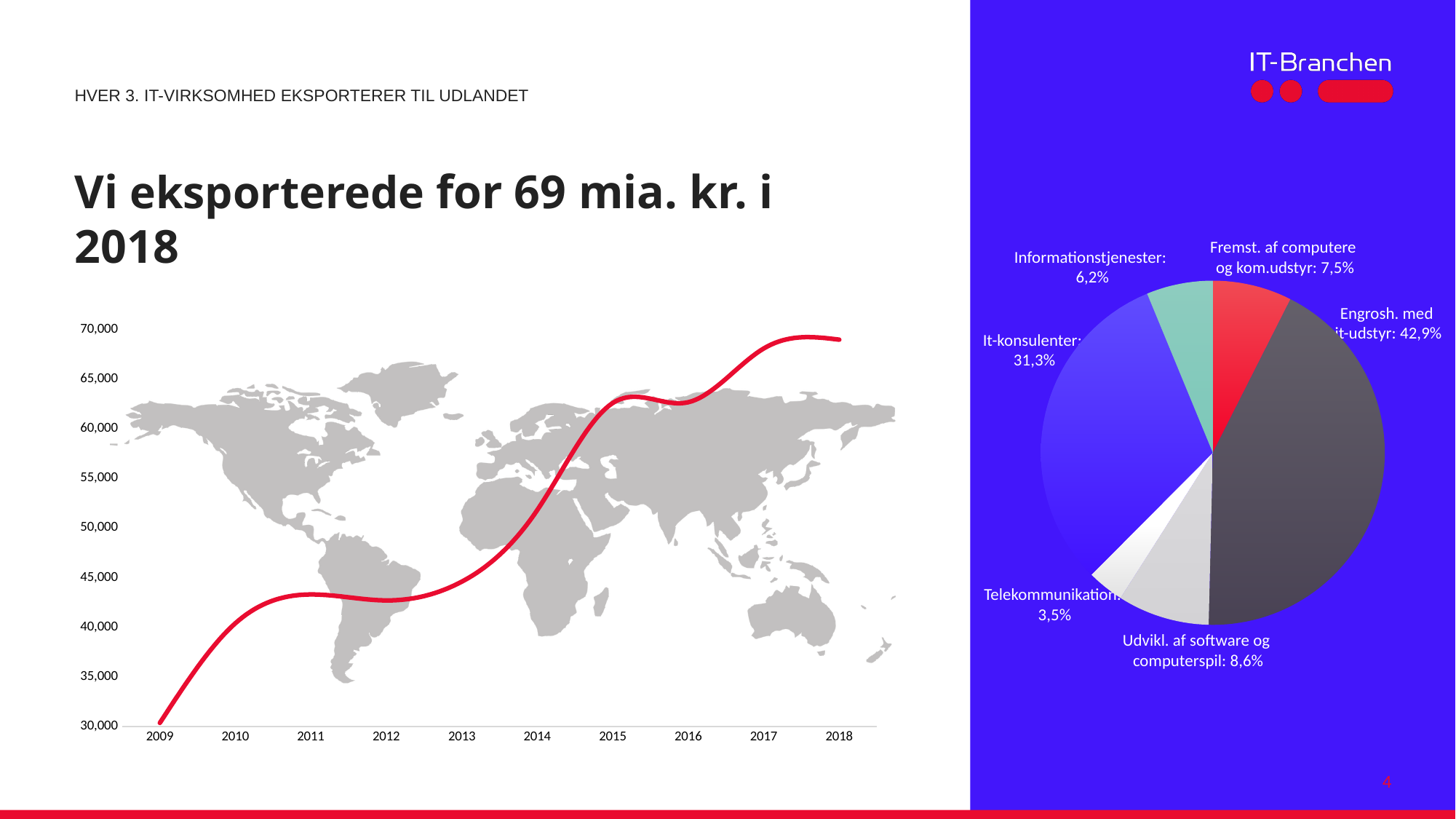
On the line chart on the left, do the values generally rise or fall from 2009 to 2018? Rise On the pie chart on the right, which category has the largest share? Engrosh. med it-udstyr How many slices does the pie chart on the right have? 6 What kind of chart is shown on the left side of the slide? Line chart On the line chart on the left, is the value for 2009 greater or less than 35,000? less On the pie chart on the right, what share does Engrosh. med it-udstyr have? 42,9% On the pie chart on the right, which category has the smallest share? Telekommunikation On the pie chart on the right, which is larger: Udvikl. af software og computerspil or Fremst. af computere og kom.udstyr? Udvikl. af software og computerspil On the pie chart on the right, what is the difference between the shares of Engrosh. med it-udstyr and It-konsulenter? 11,6% On the pie chart on the right, what share does It-konsulenter have? 31,3% On the line chart on the left, is the value for 2018 greater or less than 65,000? greater On the pie chart on the right, what share does Telekommunikation have? 3,5%